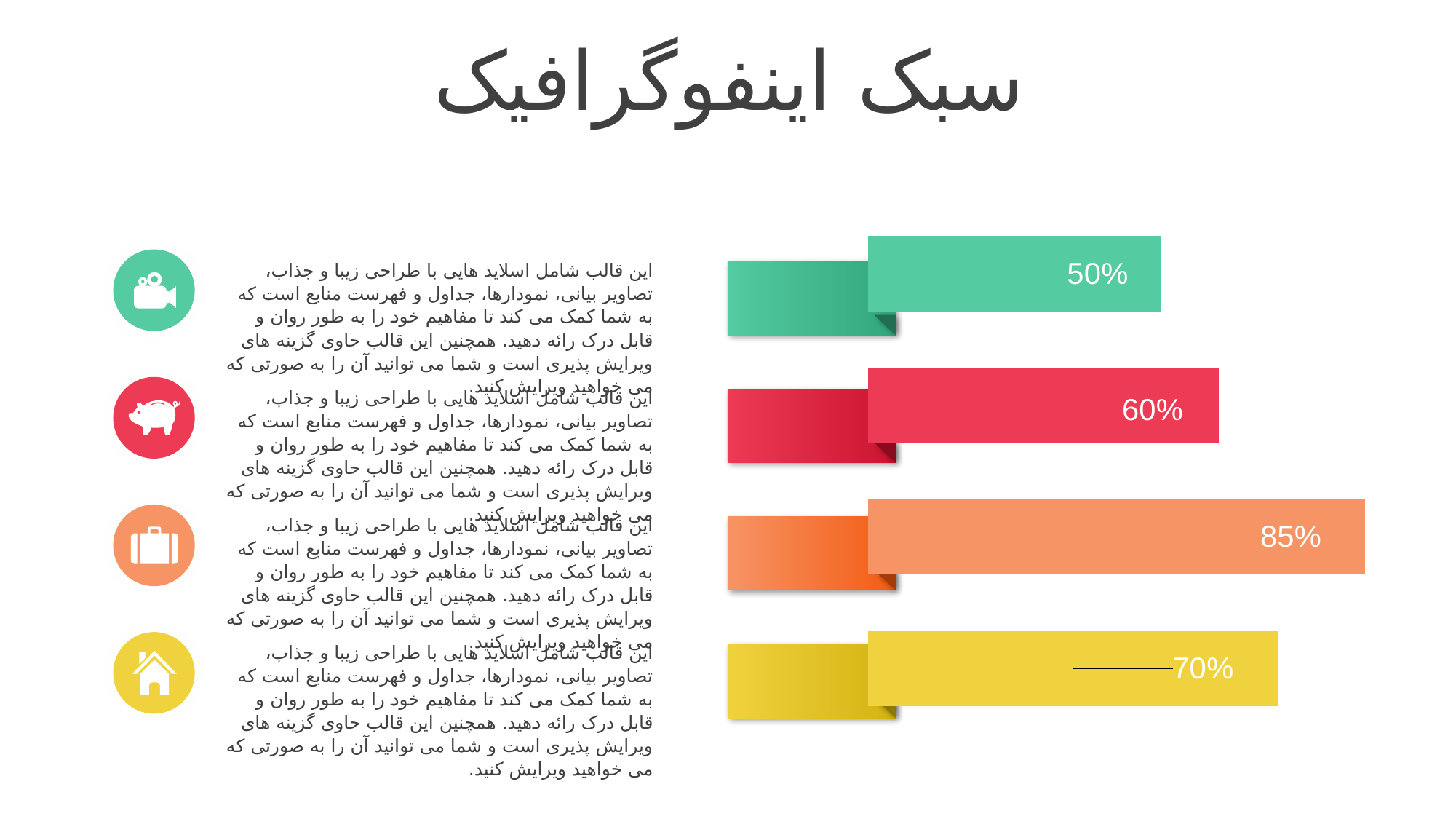
How many bars are shown in the chart? 4 What is the difference between the yellow bar's value and the red bar's value? 10% What value is shown on the yellow bar at the bottom of the chart? 70% Which is larger, the value on the red bar or the value on the yellow bar? The yellow bar (70%) What value is shown on the orange bar, third from the top? 85% Which bar has the lowest value? The green bar (50%) What value is shown on the red bar, second from the top? 60% Which bar has the highest value? The orange bar (85%) What kind of chart is shown on the slide? Bar chart What is the difference between the orange bar's value and the green bar's value? 35% What colour is the bar labelled 85%? Orange What value is shown on the green bar at the top of the chart? 50%